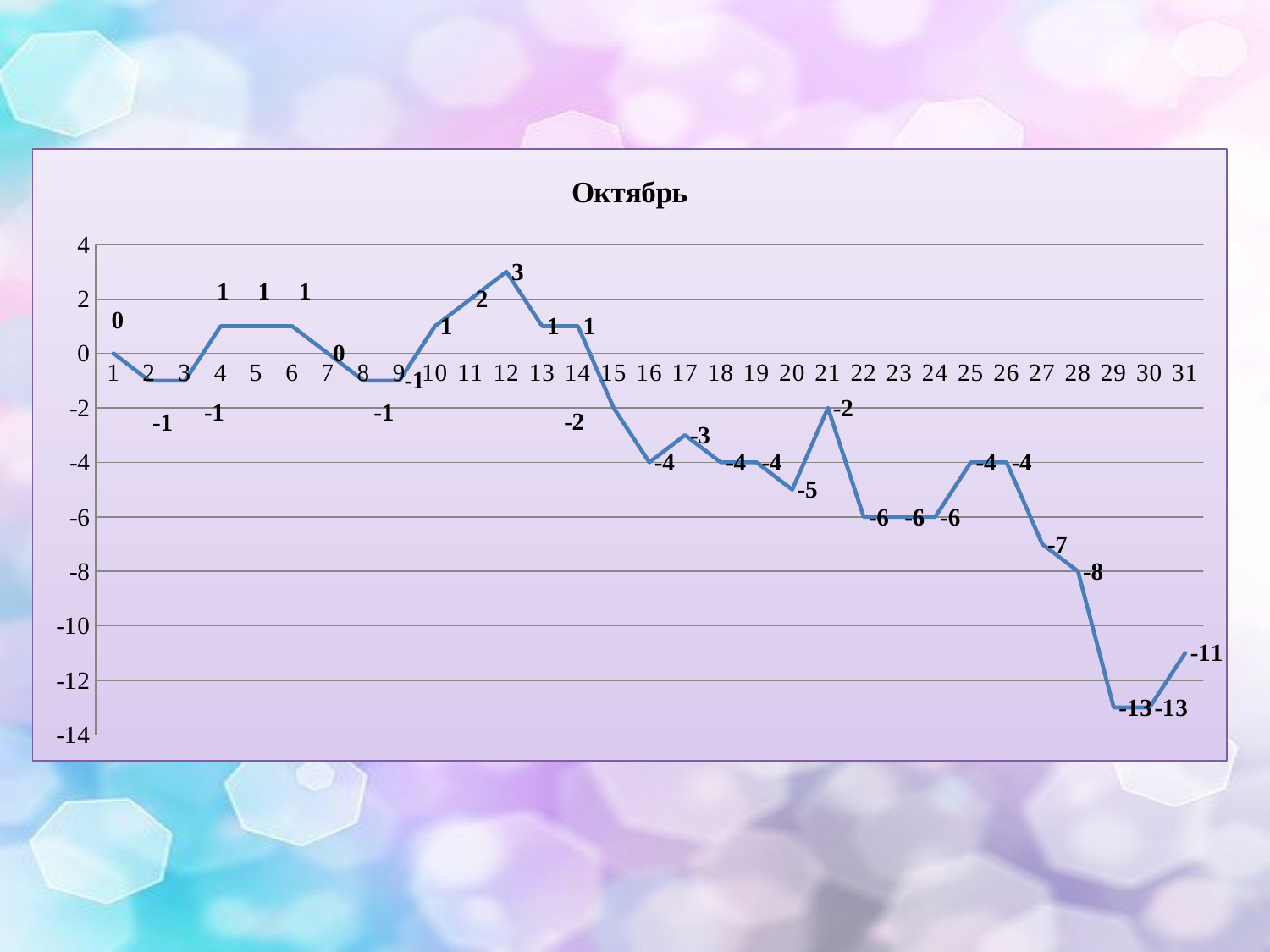
What is the title of the chart? Октябрь On which days does the lowest value of -13 occur? 29 and 30 What kind of chart is shown on the slide? line chart Which is larger, the value for day 21 or the value for day 22? day 21 What is the value for day 12? 3 Overall, do the values rise or fall from day 12 to day 30? fall What is the value for day 28? -8 What is the value for day 31? -11 What is the difference between the value for day 12 and the value for day 29? 16 Which day has the highest value? 12 What is the lowest value on the chart? -13 How many data points are plotted on the chart? 31